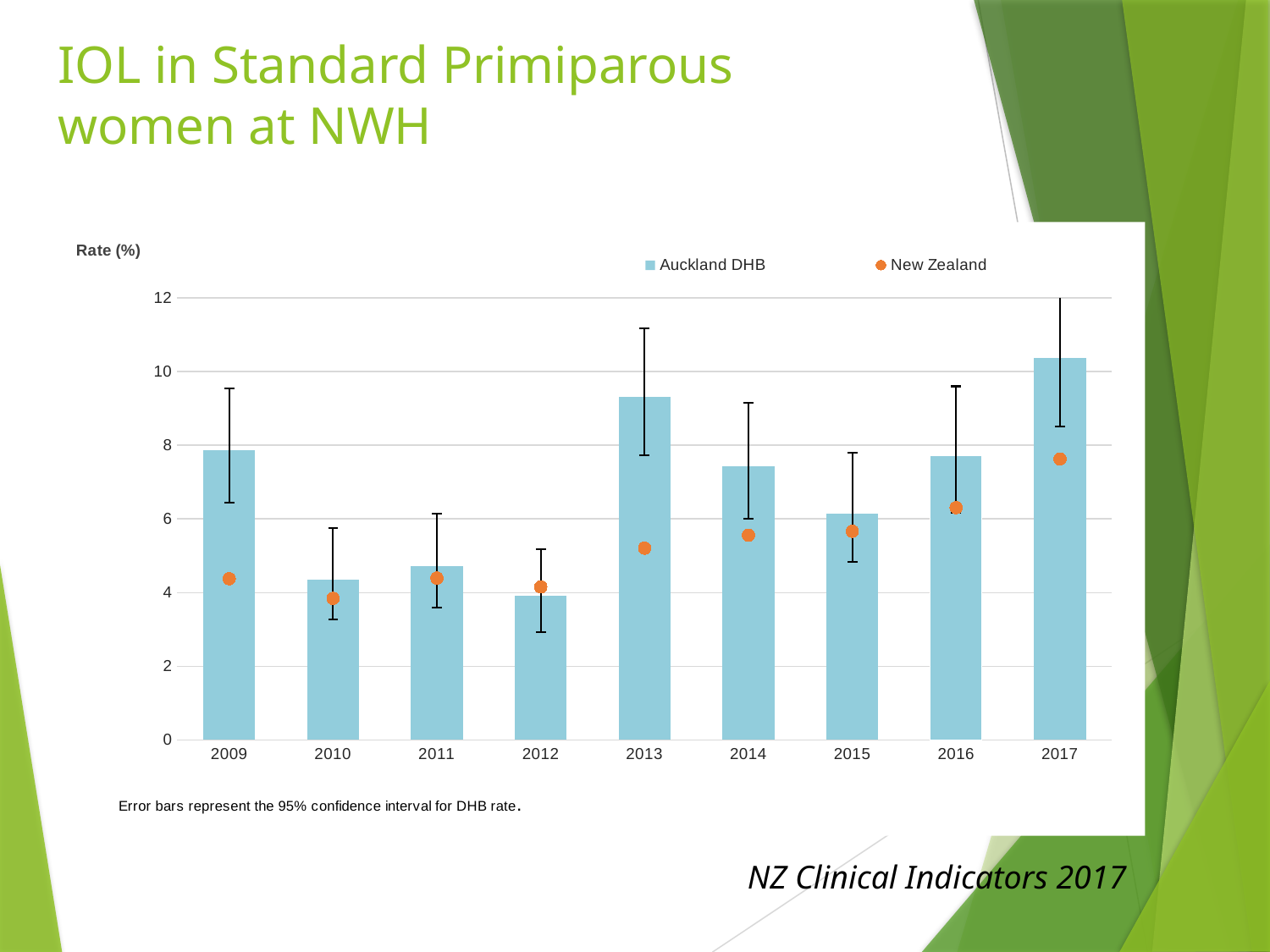
Which is larger, the Auckland DHB rate in 2013 or in 2014? 2013 Is the Auckland DHB value for 2013 greater or less than 8? greater In which year is the Auckland DHB rate highest? 2017 In which year is the New Zealand rate highest? 2017 How many series does the legend list? 2 In which year is the Auckland DHB rate lowest? 2012 How many years are shown on the x axis? 9 Does the New Zealand rate rise or fall from 2014 to 2017? rise Is the Auckland DHB value for 2017 greater or less than 10? greater What do the error bars on the chart represent? the 95% confidence interval for DHB rate What kind of chart is shown on the slide? bar chart